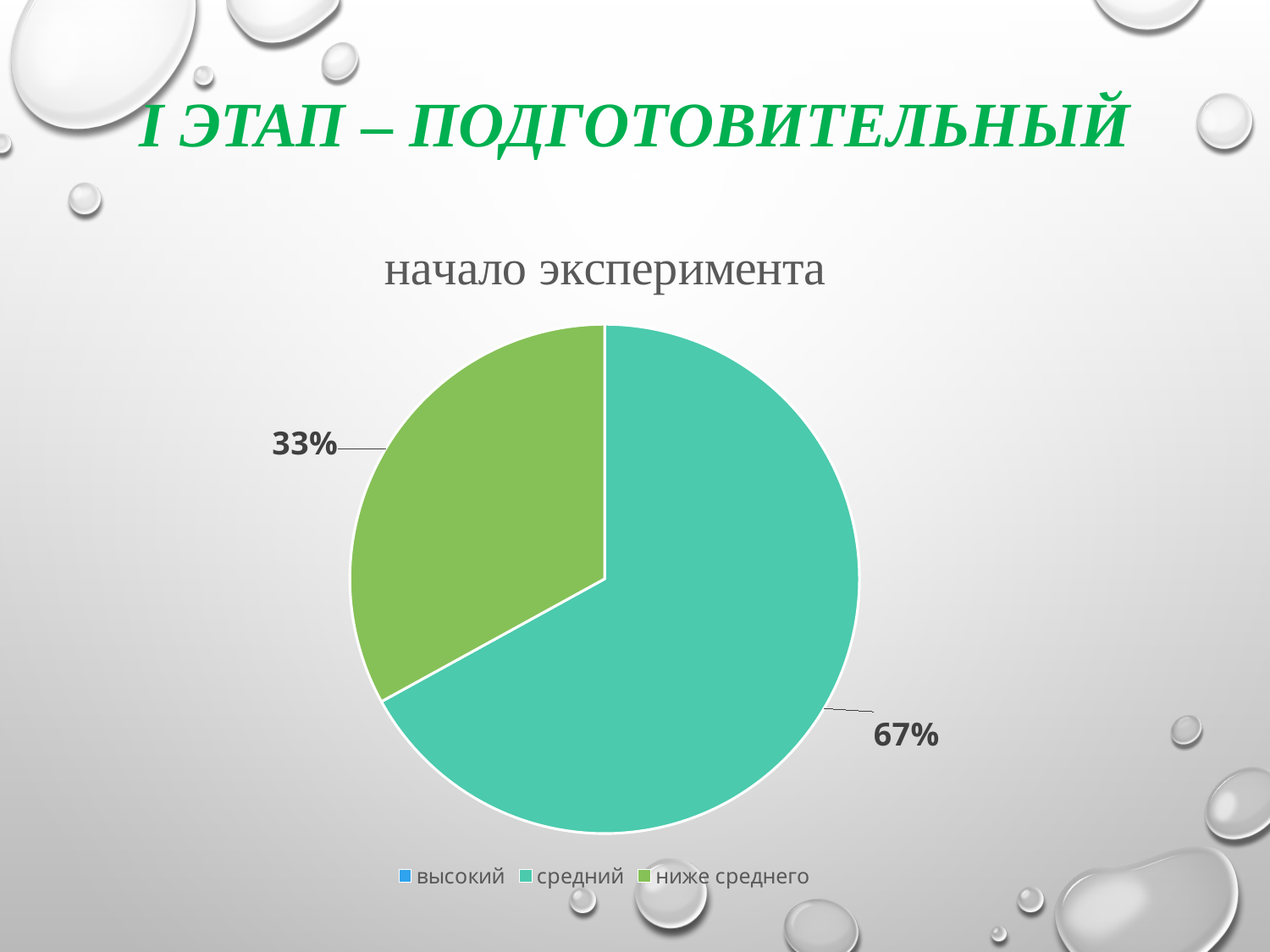
What share of the pie does the "средний" slice take? 67% Is the share for "ниже среднего" greater or less than 50%? less What is the title of the chart? начало эксперимента Which legend entry has no visible slice in the pie? высокий What share of the pie does the "ниже среднего" slice take? 33% What kind of chart is shown on the slide? pie chart How many slices are visible in the pie? 2 Which of the two visible slices is smaller, "средний" or "ниже среднего"? ниже среднего What is the difference in percentage points between the "средний" and "ниже среднего" slices? 34% How many entries does the chart legend list? 3 Which is larger, the "средний" slice or the "ниже среднего" slice? средний Which category has the largest slice of the pie? средний